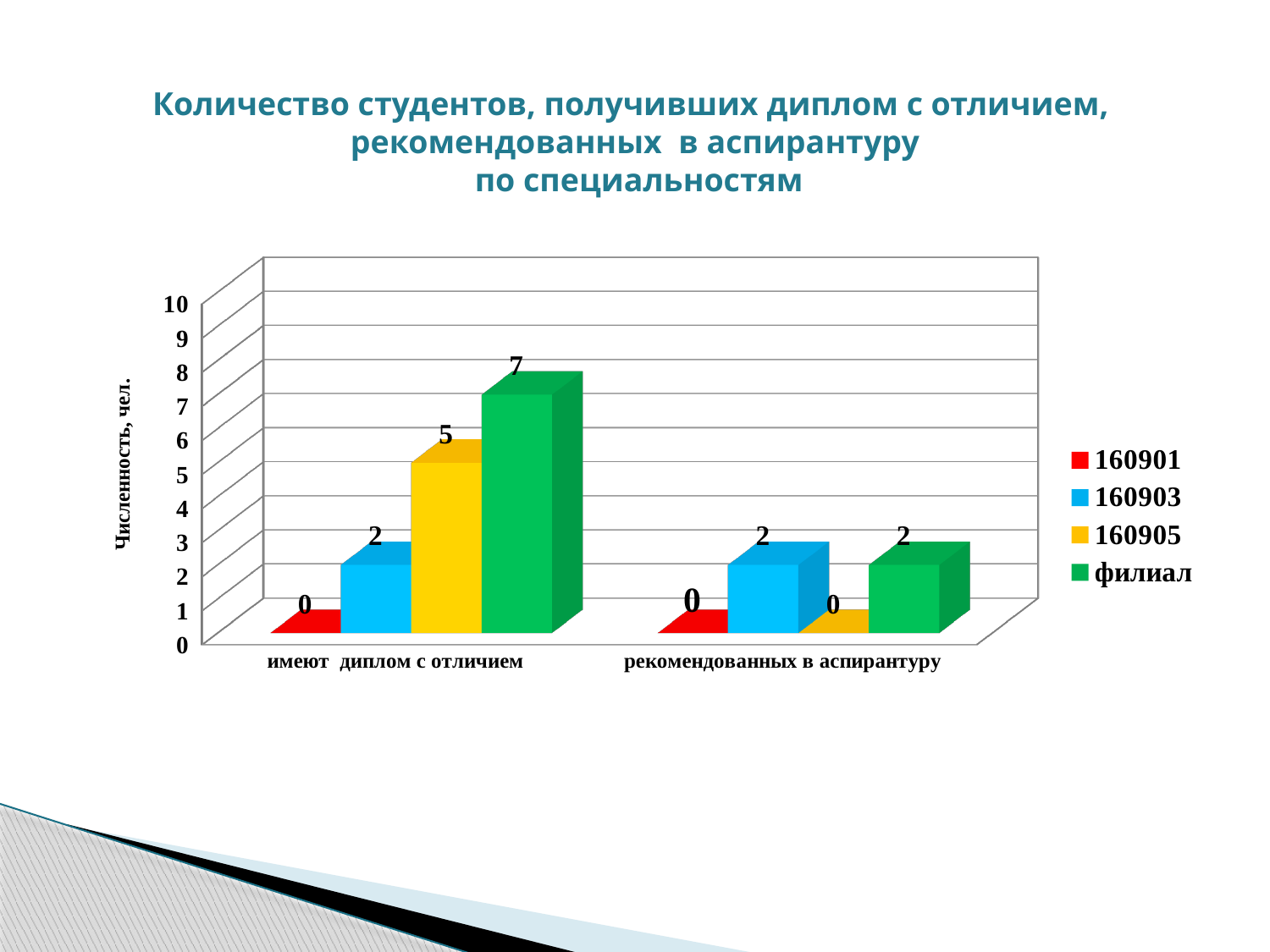
What kind of chart is shown on the slide? bar chart What is the value for 160905 in the category "рекомендованных в аспирантуру"? 0 How many series does the legend list? 4 What is the difference between the филиал and 160905 values in the category "имеют диплом с отличием"? 2 Which series has the highest value in the category "имеют диплом с отличием"? филиал What colour are the bars for the series 160901? red What is the value for филиал in the category "имеют диплом с отличием"? 7 What is the value for 160905 in the category "имеют диплом с отличием"? 5 Which is larger: the 160903 value or the 160905 value in the category "имеют диплом с отличием"? 160905 What is the value for 160903 in the category "рекомендованных в аспирантуру"? 2 What is the label of the vertical axis? Численность, чел. How many categories are shown on the x axis? 2